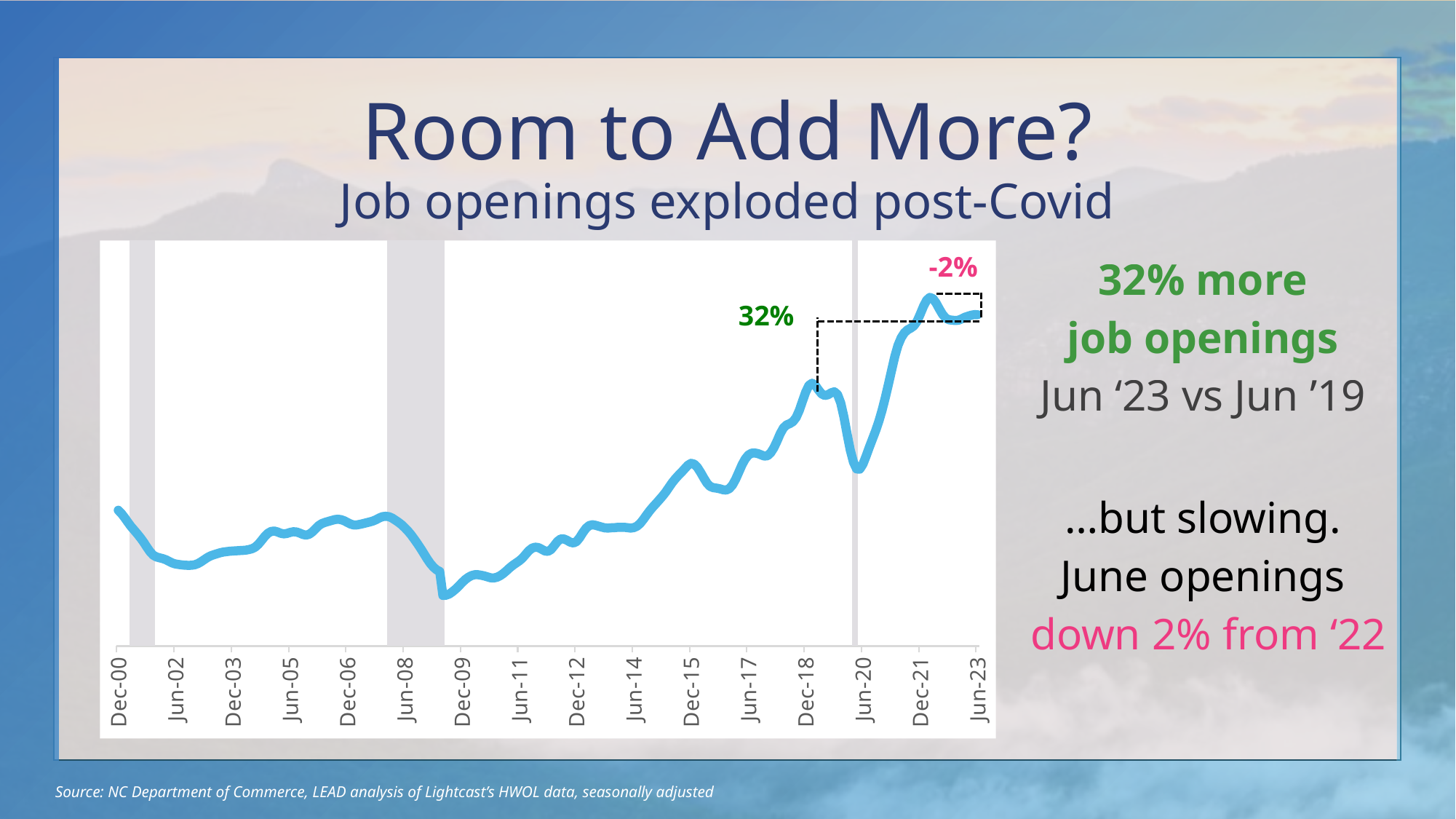
What is the last date label on the x axis of the chart? Jun-23 What is the title of the slide containing the chart? Room to Add More? What kind of chart is shown on the slide? line chart Is the value of the line at Jun-23 higher or lower than at Dec-00? higher Around which x-axis label does the line reach its lowest point? Dec-09 According to the chart annotation, by what percentage did June job openings change from '22 to '23? -2% How many date labels are shown along the x axis of the chart? 16 What is the first date label on the x axis of the chart? Dec-00 According to the chart annotation, by what percentage are job openings higher in Jun '23 compared with Jun '19? 32% What source is cited for the chart data? NC Department of Commerce, LEAD analysis of Lightcast's HWOL data, seasonally adjusted Does the line generally rise or fall between Dec-09 and Dec-18? rise Is the value of the line at Dec-09 higher or lower than at Dec-00? lower